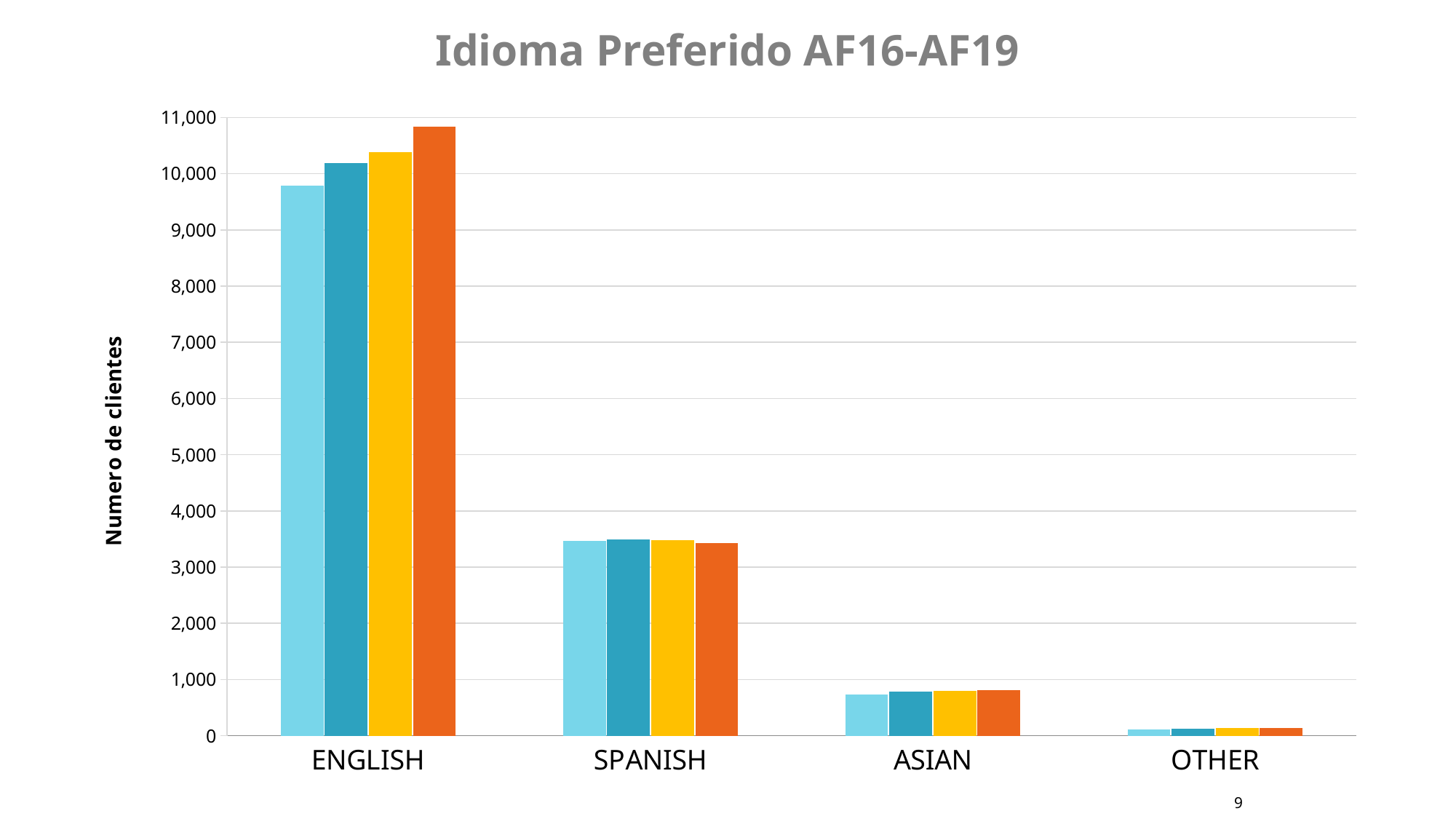
Are the values for SPANISH greater or less than 4,000? less Are the values for ASIAN greater or less than 1,000? less What is the title of the chart? Idioma Preferido AF16-AF19 Which language category has the highest number of clients? ENGLISH Are the values for ENGLISH greater or less than 9,000? greater Which language category has the lowest number of clients? OTHER Which has more clients, SPANISH or ASIAN? SPANISH What is the label on the vertical axis? Numero de clientes Do the four bars for ENGLISH rise or fall from left to right? rise How many language categories are shown on the x axis? 4 What kind of chart is shown on the slide? bar chart